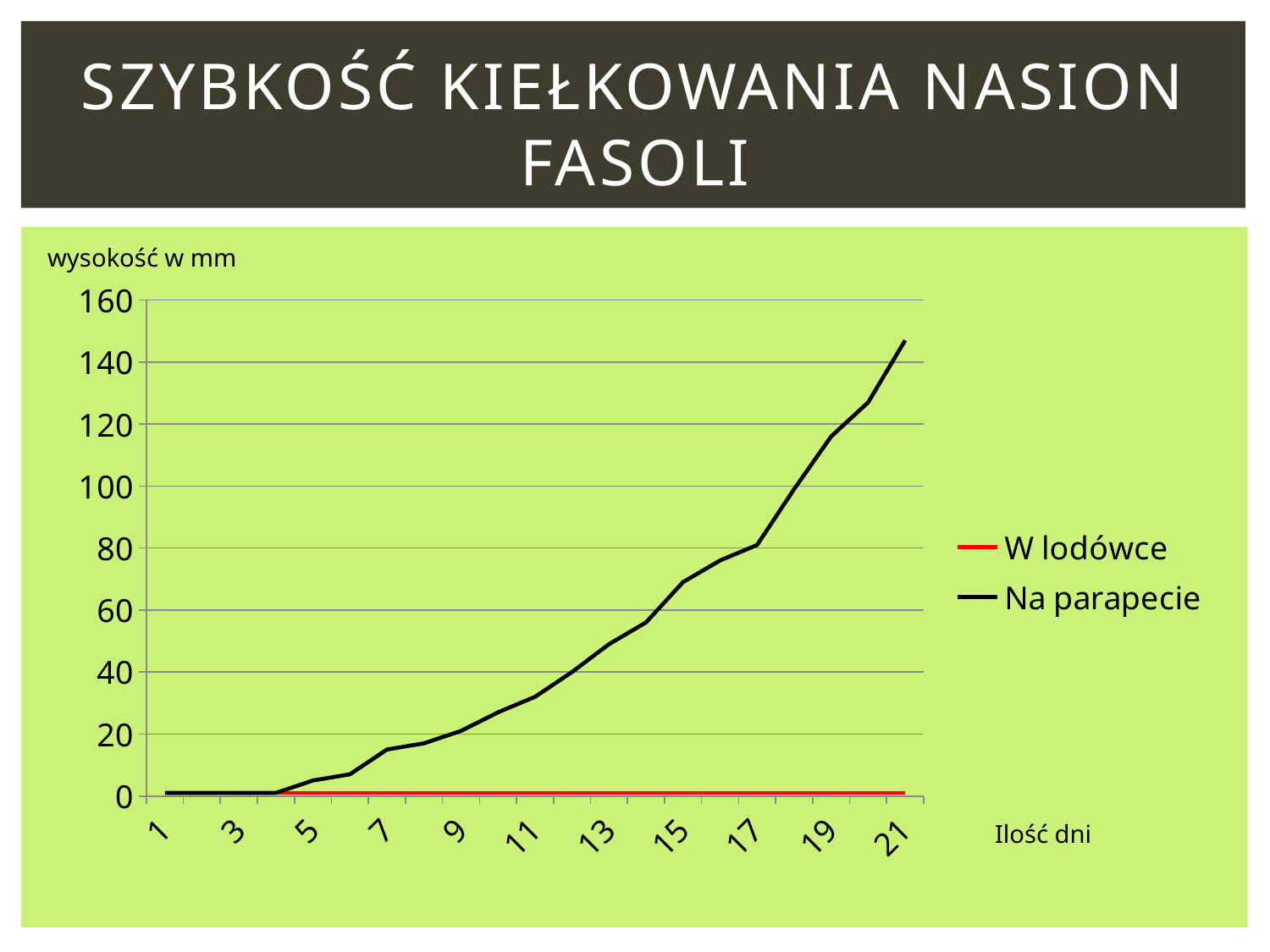
Which series is drawn in red? W lodówce Does the value for 'W lodówce' rise, fall or stay flat across the days? stay flat Is the value for 'Na parapecie' at day 19 greater or less than 100? greater Is the value for 'Na parapecie' at day 15 greater or less than 60? greater Is the value for 'Na parapecie' at day 9 greater or less than 40? less Does the value for 'Na parapecie' rise or fall as the number of days increases? rise How many series does the legend list? 2 What kind of chart is shown on the slide? line chart At day 21, which series has the higher value, 'W lodówce' or 'Na parapecie'? Na parapecie What is the label on the vertical axis? wysokość w mm